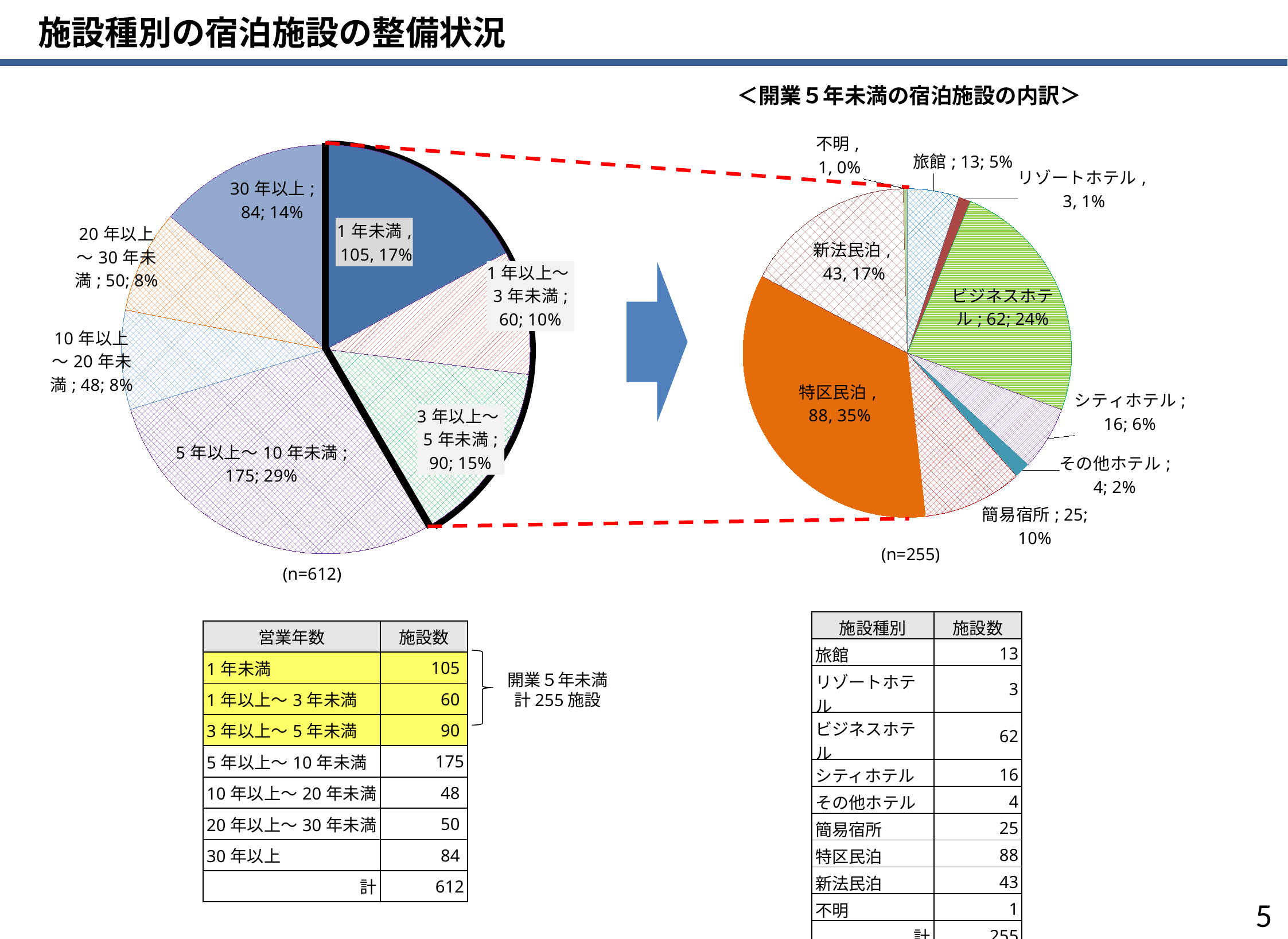
In the right pie chart (開業5年未満の宿泊施設の内訳), what share of the pie is 新法民泊? 17% In the right pie chart (開業5年未満の宿泊施設の内訳), which category has the largest slice? 特区民泊 In the right pie chart (開業5年未満の宿泊施設の内訳), what is the value for ビジネスホテル? 62 In the left pie chart (n=612), what is the difference between 1年未満 and 3年以上～5年未満? 15 In the right pie chart (開業5年未満の宿泊施設の内訳), what is the difference between 特区民泊 and 新法民泊? 45 In the right pie chart (開業5年未満の宿泊施設の内訳), which is larger, 簡易宿所 or シティホテル? 簡易宿所 In the left pie chart (n=612), what share of the pie is 1年未満? 17% In the left pie chart (n=612), which category has the largest slice? 5年以上～10年未満 How many slices does the left pie chart (n=612) have? 7 In the left pie chart (n=612), which category has the smallest slice? 10年以上～20年未満 In the left pie chart (n=612), what is the value for 5年以上～10年未満? 175 What type of chart is the left chart (n=612)? pie chart